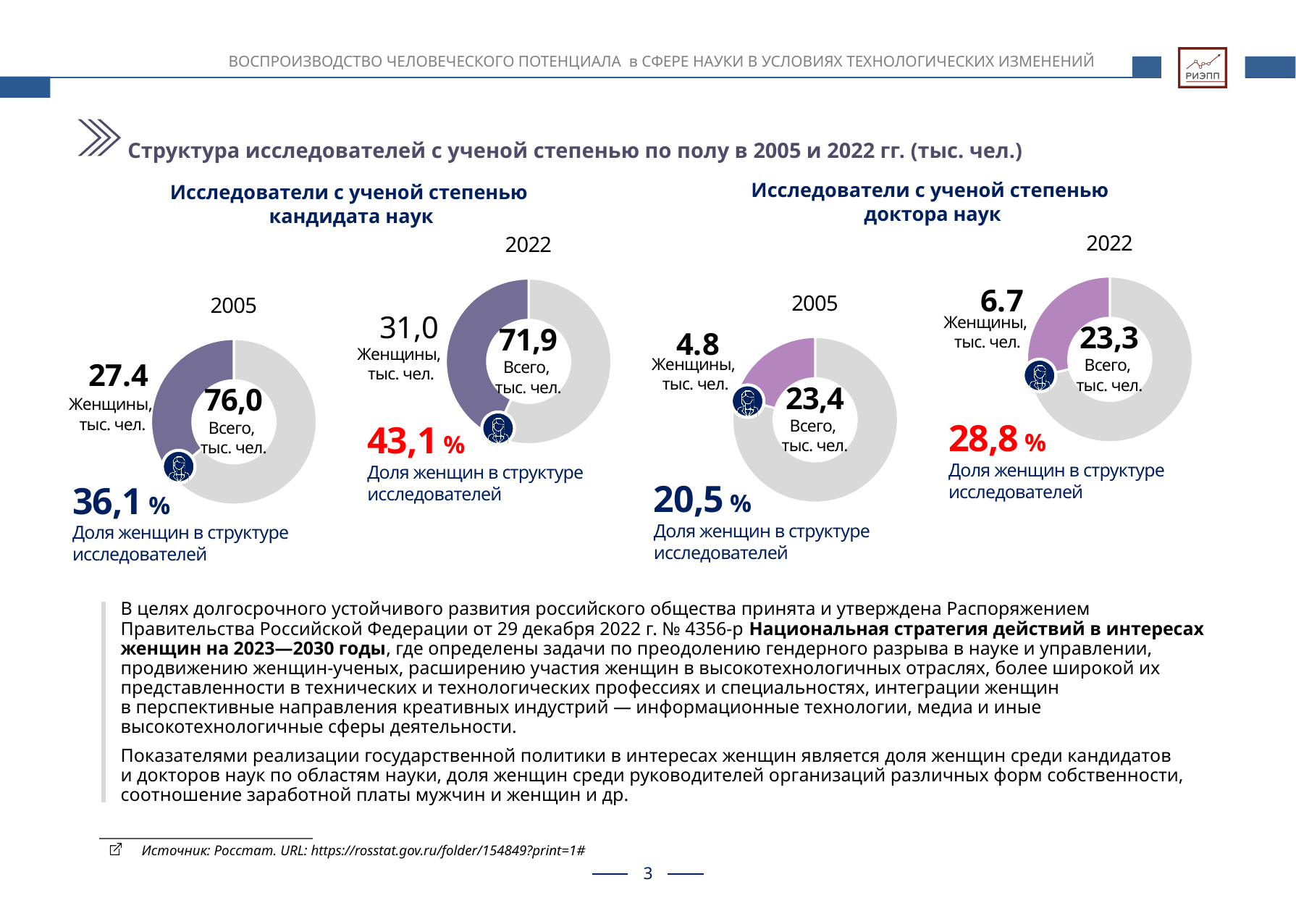
How many donut charts are shown on the slide? 4 Which of the four donut charts shows the lowest share of women among researchers? Doctor of sciences, 2005 In the 2022 donut chart for researchers with a doctor of sciences degree, how many women are shown (thousand people)? 6.7 What type of chart is used to show the structure of researchers by sex on this slide? Donut (pie) chart In the 2005 donut chart for researchers with a doctor of sciences degree, what share of researchers are women? 20,5 % In the 2022 donut chart for researchers with a candidate of sciences degree, what share of researchers are women? 43,1 % For researchers with a candidate of sciences degree, is the share of women larger in 2005 or in 2022? 2022 For researchers with a doctor of sciences degree, by how many percentage points did the share of women change from 2005 to 2022? 8,3 Which of the four donut charts shows the highest share of women among researchers? Candidate of sciences, 2022 In the 2022 donut chart for researchers with a doctor of sciences degree, what is the total number of researchers shown in the centre? 23,3 In the 2005 donut chart for researchers with a candidate of sciences degree, how many women are shown (thousand people)? 27.4 In the 2005 donut chart for researchers with a candidate of sciences degree, what is the total number of researchers shown in the centre? 76,0